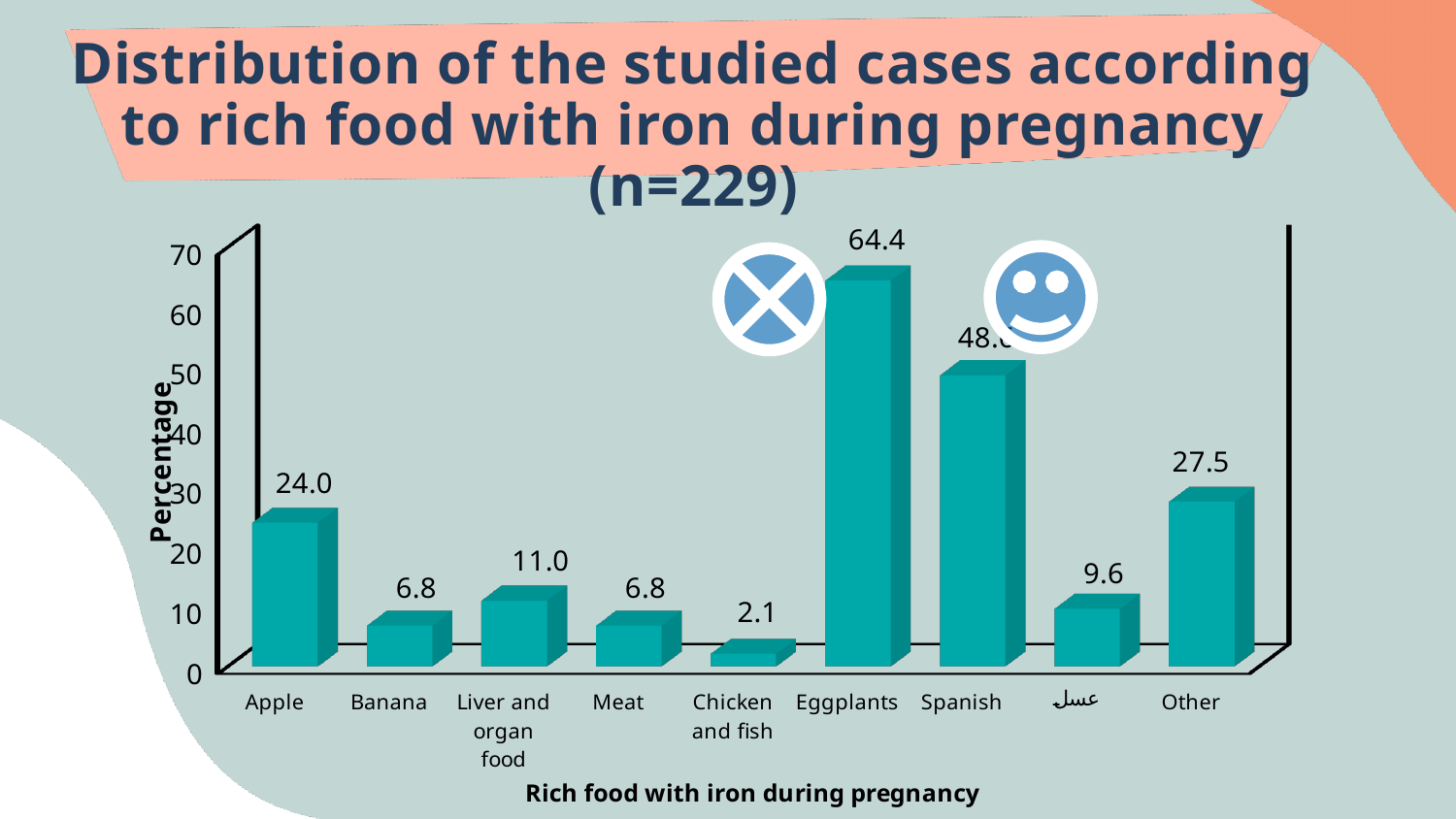
How many categories are shown on the x axis? 9 Is the value for Spanish greater or less than 40? greater What is the value for Eggplants? 64.4 Which is larger, the value for Liver and organ food or the value for Banana? Liver and organ food What kind of chart is shown on the slide? bar chart What is the difference between the values for Eggplants and Other? 36.9 What is the value for Apple? 24.0 What is the value for Chicken and fish? 2.1 Which category has the highest value? Eggplants Which category has the lowest value? Chicken and fish What is the label of the vertical axis? Percentage What is the value for Other? 27.5